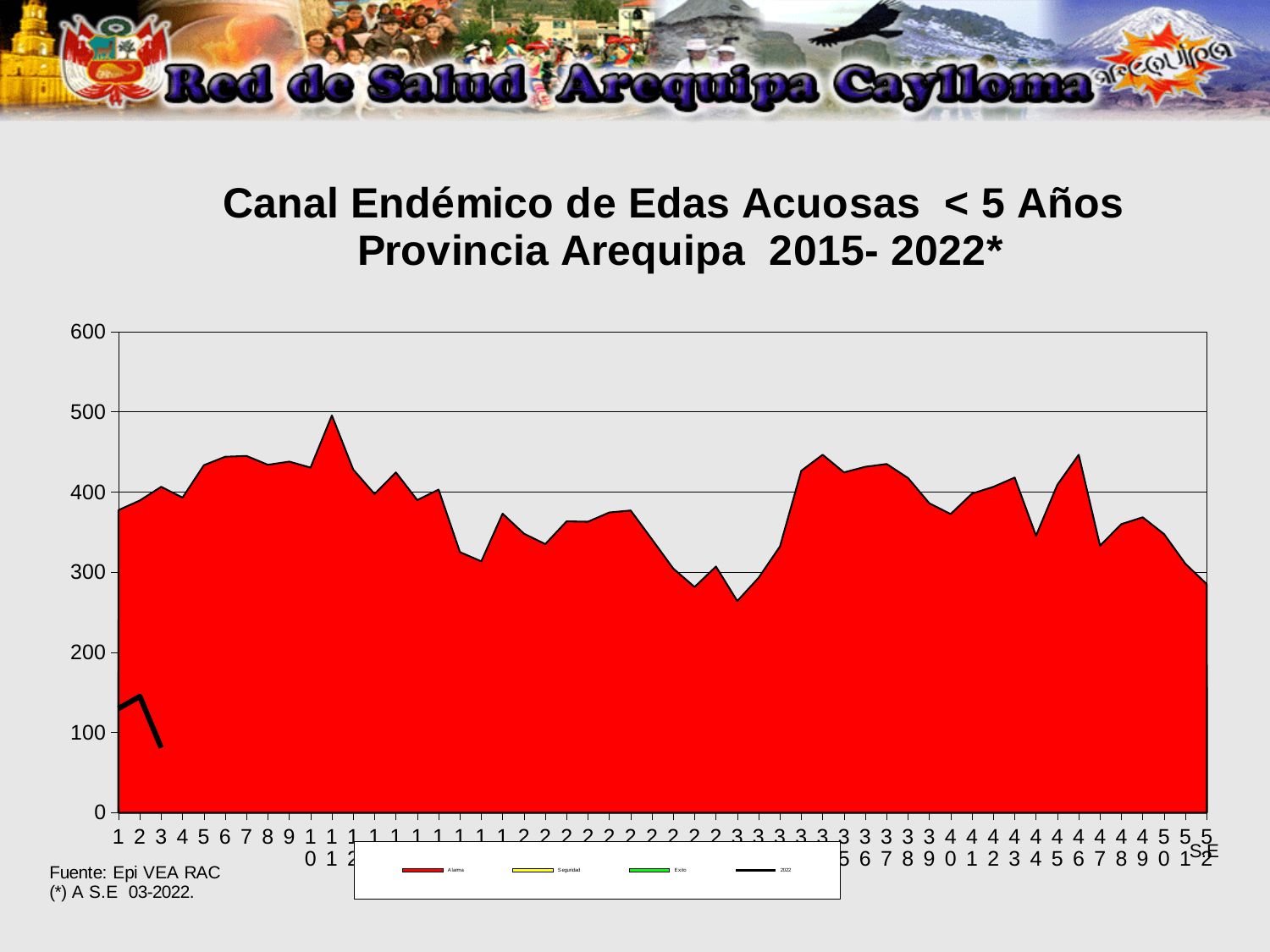
How many series does the chart legend list? 4 Is the 2022 value at week 3 greater or less than 100? less At which week does the Alarma series reach its highest value? 11 What kind of chart is shown on the slide? Combination area and line chart How many epidemiological weeks (S.E) are shown along the x axis? 52 Is the 2022 value at week 2 greater or less than 100? greater Does the 2022 line rise or fall from week 2 to week 3? Fall Is the Alarma value at week 11 greater or less than 450? greater What is the title of the chart on the slide? Canal Endémico de Edas Acuosas < 5 Años Provincia Arequipa 2015- 2022* What colour is the Alarma series in the chart? Red Which is larger, the Alarma value at week 11 or at week 33? Week 11